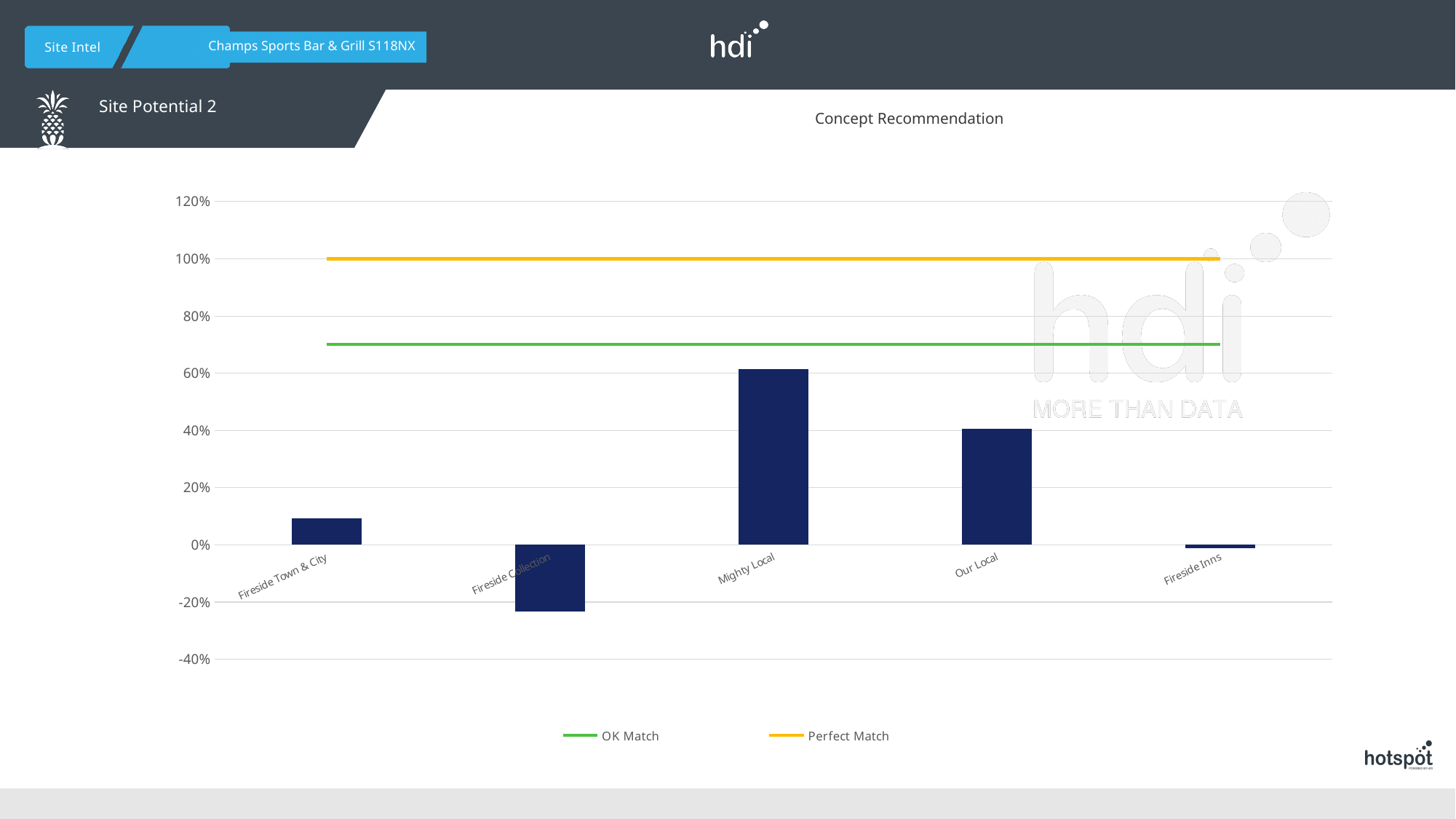
Which concept has the lowest bar? Fireside Collection How many series does the legend list? 2 What kind of chart is shown on the slide? Combination bar and line chart Is the value for Fireside Town & City greater or less than 20%? less Which concept has the highest bar? Mighty Local Which is larger, the value for Fireside Town & City or the value for Fireside Inns? Fireside Town & City Which is larger, the value for Mighty Local or the value for Our Local? Mighty Local Is the value for Fireside Collection greater or less than 0%? less At what level on the y axis is the Perfect Match line drawn? 100% Is the value for Mighty Local greater or less than 40%? greater What are the two entries listed in the legend? OK Match and Perfect Match How many concept categories are plotted along the x axis? 5